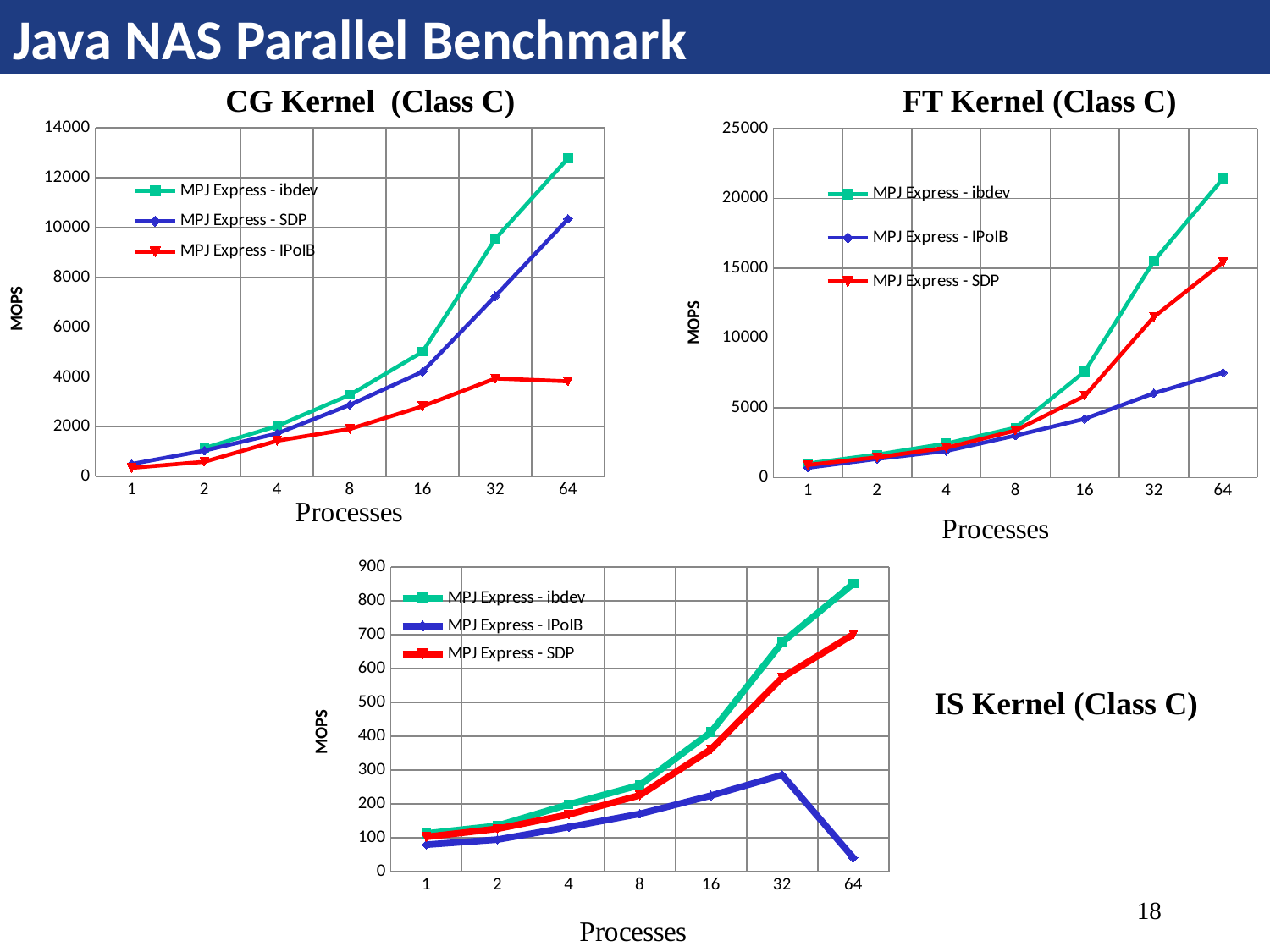
How many series does the legend of the FT Kernel (Class C) chart list? 3 In the FT Kernel (Class C) chart, which series has the lowest value at 64 processes? MPJ Express - IPoIB In the IS Kernel (Class C) chart, does the MPJ Express - IPoIB series rise or fall between 32 and 64 processes? fall In the CG Kernel (Class C) chart, is the value for MPJ Express - IPoIB at 64 processes greater or less than 6000? less In the IS Kernel (Class C) chart, is the value for MPJ Express - ibdev at 64 processes greater or less than 800? greater In the CG Kernel (Class C) chart, is the value for MPJ Express - ibdev at 64 processes greater or less than 12000? greater What is the label of the y axis on the IS Kernel (Class C) chart? MOPS What kind of chart is the CG Kernel (Class C) chart? line chart In the CG Kernel (Class C) chart, which series has the highest value at 64 processes? MPJ Express - ibdev In the FT Kernel (Class C) chart, which is larger at 32 processes, MPJ Express - SDP or MPJ Express - IPoIB? MPJ Express - SDP How many process counts are plotted along the x axis of the IS Kernel (Class C) chart? 7